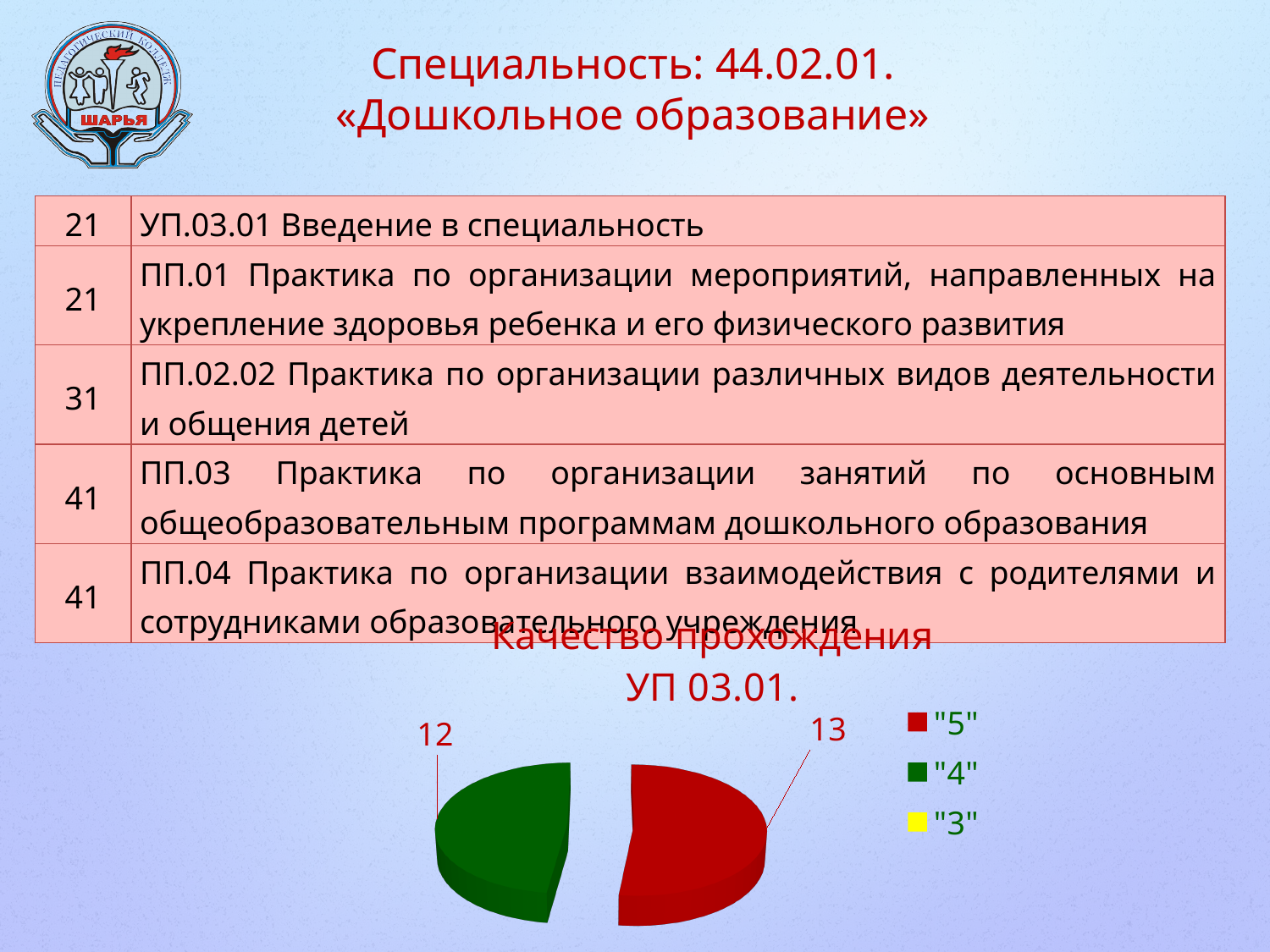
What value is shown for the "4" slice of the pie chart? 12 What colour is the "5" slice in the pie chart? red Which is larger in the pie chart, the value for "5" or the value for "4"? "5" How many entries does the legend of the pie chart list? 3 What is the title of the pie chart? Качество прохождения УП 03.01. What kind of chart is shown on the slide? pie chart What value is shown for the "5" slice of the pie chart? 13 Which grade has the largest slice in the pie chart? "5" What is the difference between the value for "5" and the value for "4" in the pie chart? 1 Is the value for "5" in the pie chart greater or less than 10? greater